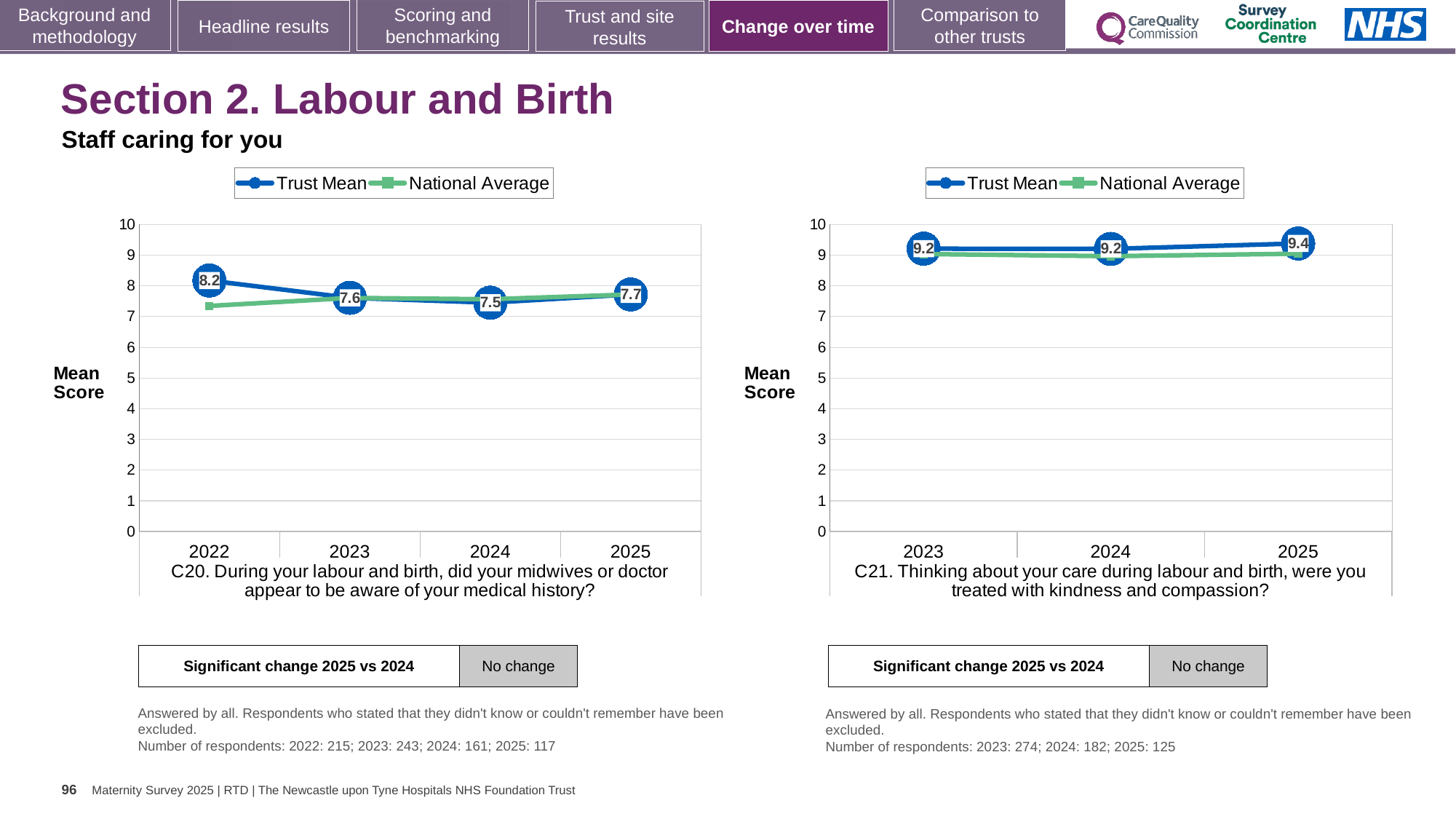
In the C20 chart on the left, what is the Trust Mean for 2022? 8.2 In the C20 chart on the left, what is the difference between the Trust Mean for 2022 and for 2025? 0.5 What kind of chart is the C20 chart on the left? line chart In the C20 chart on the left, does the Trust Mean rise or fall from 2022 to 2024? fall In the C21 chart on the right, what is the Trust Mean for 2025? 9.4 In the C20 chart on the left, what is the Trust Mean for 2024? 7.5 In the C20 chart on the left, which year has the lowest Trust Mean? 2024 In the C21 chart on the right, what is the difference between the Trust Mean for 2025 and for 2024? 0.2 How many series does the legend of the C21 chart on the right list? 2 In the C20 chart on the left, is the National Average for 2022 greater or less than 8? less In the C20 chart on the left, which year has the highest Trust Mean? 2022 In the C21 chart on the right, how many years are shown on the x axis? 3